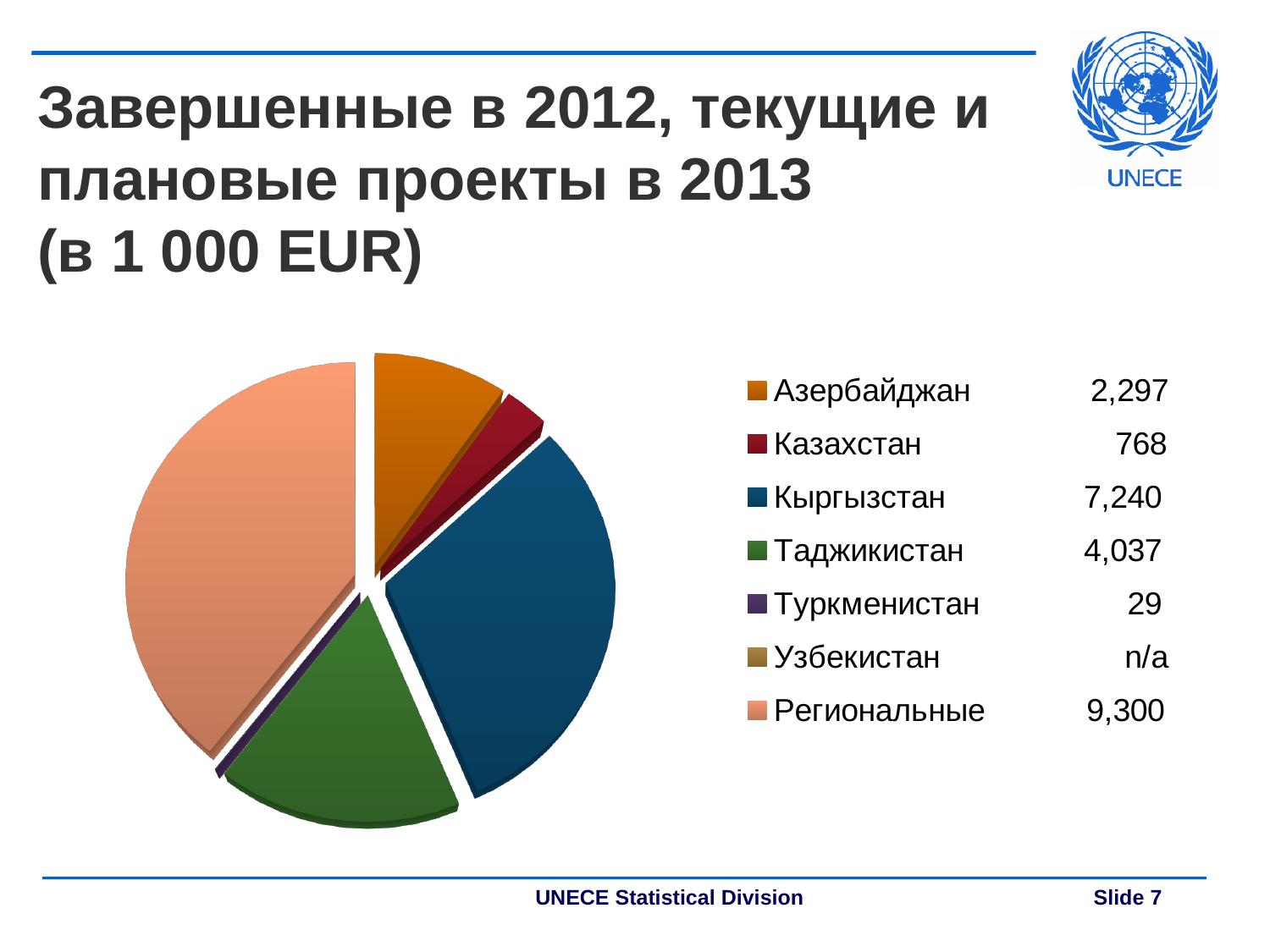
What is the value for Туркменистан? 29 Which is larger, the value for Таджикистан or the value for Азербайджан? Таджикистан What value is shown for Узбекистан? n/a What is the difference between the values for Региональные and Кыргызстан? 2,060 What is the value for Кыргызстан? 7,240 What is the difference between the values for Азербайджан and Казахстан? 1,529 Among the categories with a numeric value, which has the lowest value? Туркменистан Which category has the highest value? Региональные How many categories does the legend list? 7 What unit is stated in the slide title for the values? 1 000 EUR What is the value for Региональные? 9,300 What kind of chart is shown on the slide? Pie chart